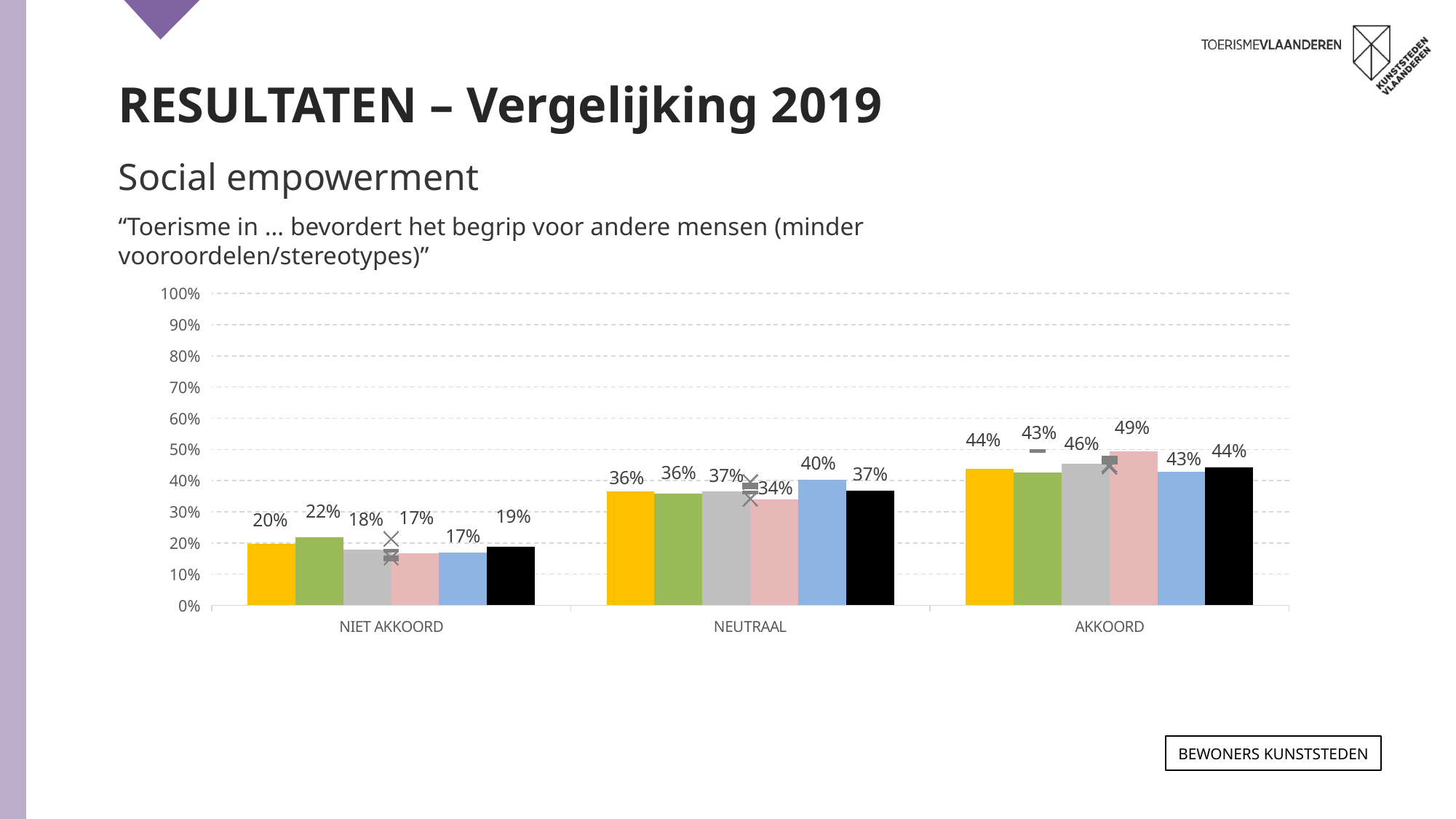
What is the value of the pink bar for AKKOORD? 49% What is the value of the blue bar for NEUTRAAL? 40% What is the value of the black bar for NIET AKKOORD? 19% How many categories are shown on the x axis of the chart? 3 What is the difference between the blue bar (40%) and the pink bar (34%) in the NEUTRAAL category? 6 percentage points Which bar is the highest in the AKKOORD category? the pink bar (49%) Is the value of the grey bar for AKKOORD greater or less than 40%? greater What is the value of the yellow bar for NIET AKKOORD? 20% How many bars are shown in each category of the chart? 6 Which is larger for the green bar: NIET AKKOORD or AKKOORD? AKKOORD Which bar is the lowest in the NEUTRAAL category? the pink bar (34%) What kind of chart is shown on the slide? bar chart